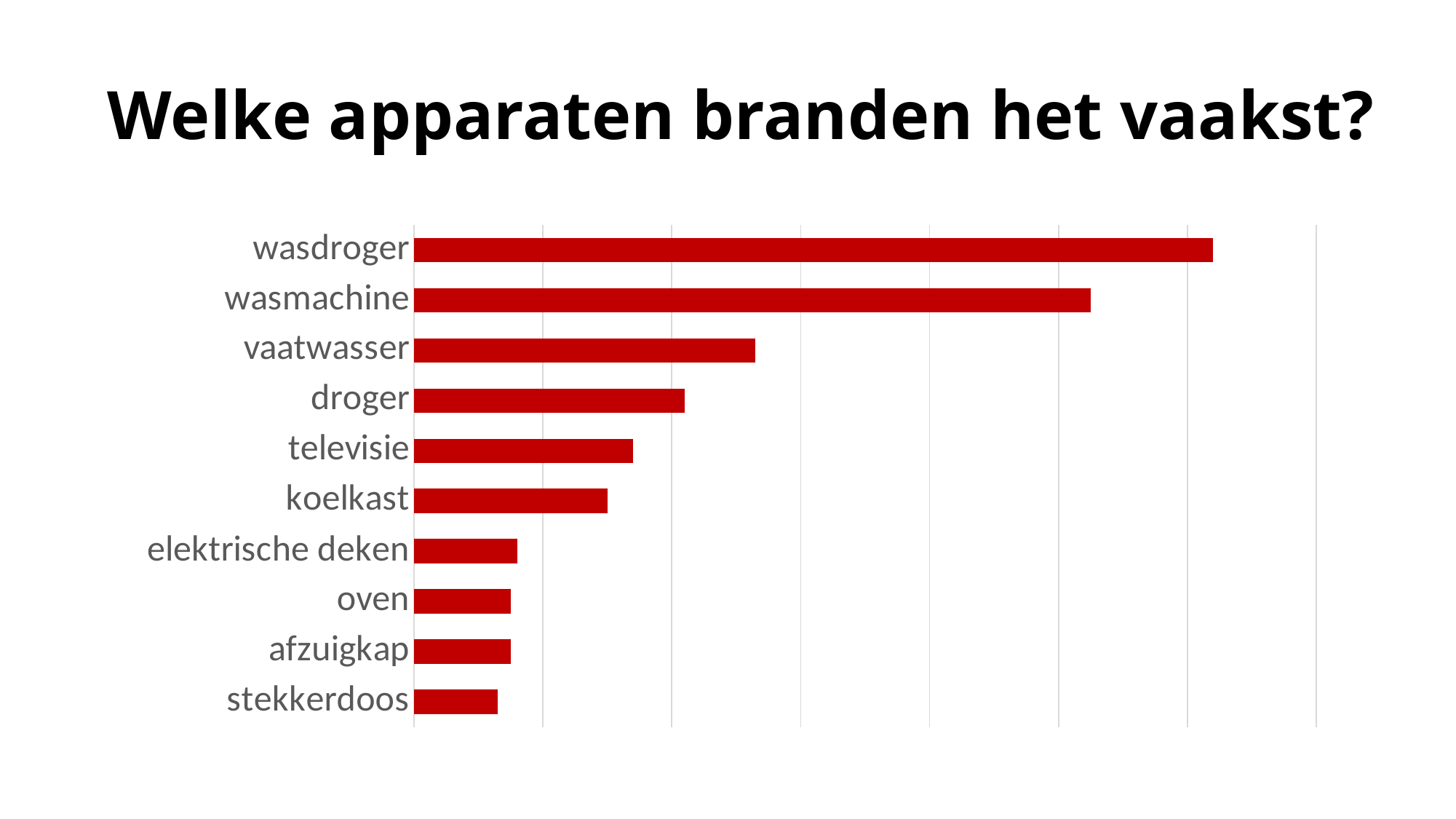
Which appliance has the highest value in the chart? wasdroger What is the title of the chart on the slide? Welke apparaten branden het vaakst? Which has the larger value, koelkast or elektrische deken? koelkast Which has the larger value, televisie or stekkerdoos? televisie What colour are the bars in the chart? red Which has the larger value, wasdroger or wasmachine? wasdroger How many categories (appliances) are shown in the chart? 10 Do the bar values generally decrease or increase going from the top category to the bottom category? decrease What kind of chart is shown on the slide? bar chart Which appliance has the lowest value in the chart? stekkerdoos